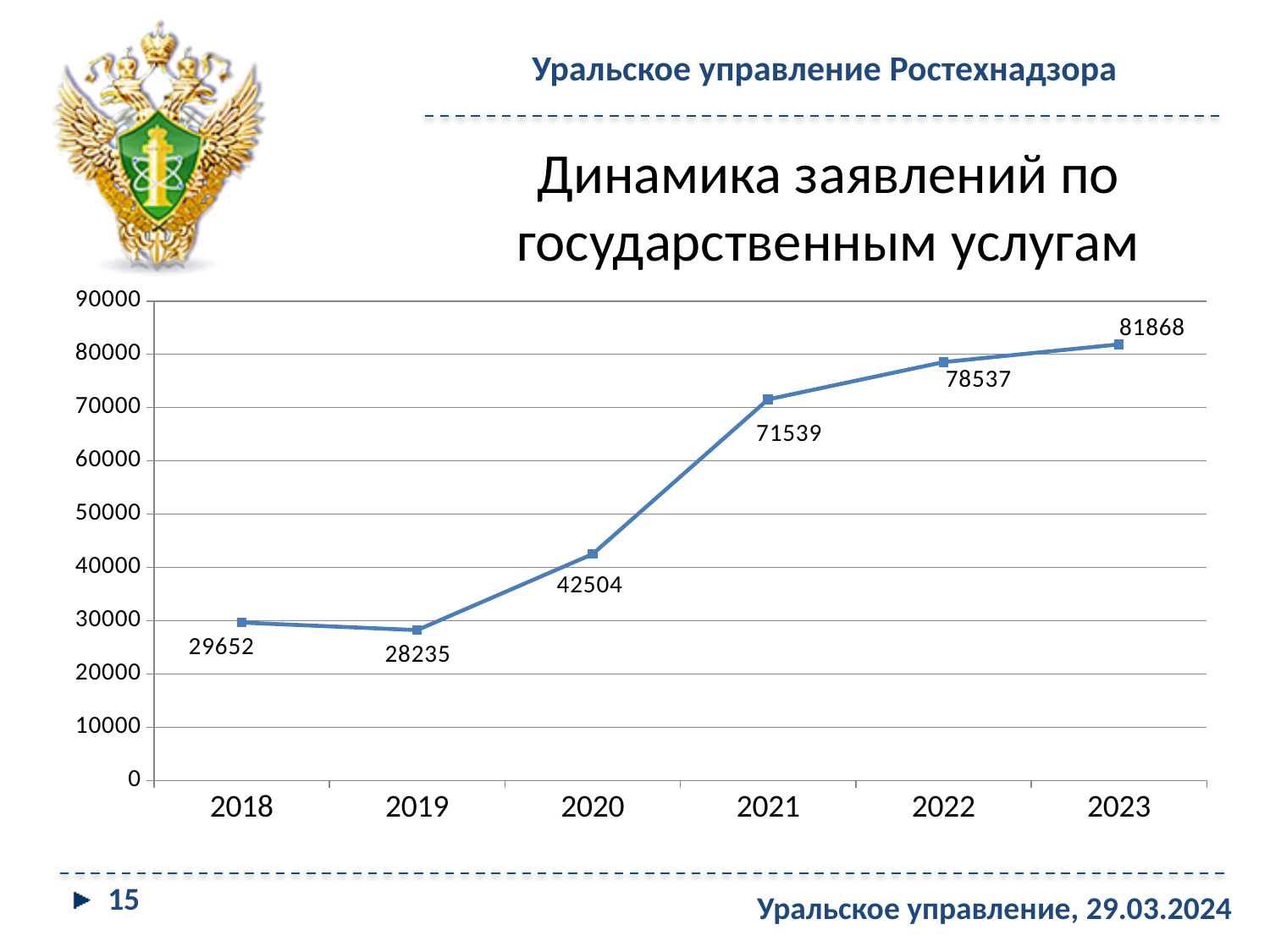
Is the value for 2020 greater or less than 40000? greater Which is larger, the value for 2018 or the value for 2019? 2018 Do the values rise or fall from 2019 to 2023? rise Which year has the lowest value? 2019 What kind of chart is shown on the slide? line chart How many years are plotted on the chart? 6 What is the value for 2021? 71539 What is the difference between the values for 2021 and 2020? 29035 What is the difference between the values for 2023 and 2022? 3331 What is the value for 2018? 29652 What is the value for 2023? 81868 Which year has the highest value? 2023